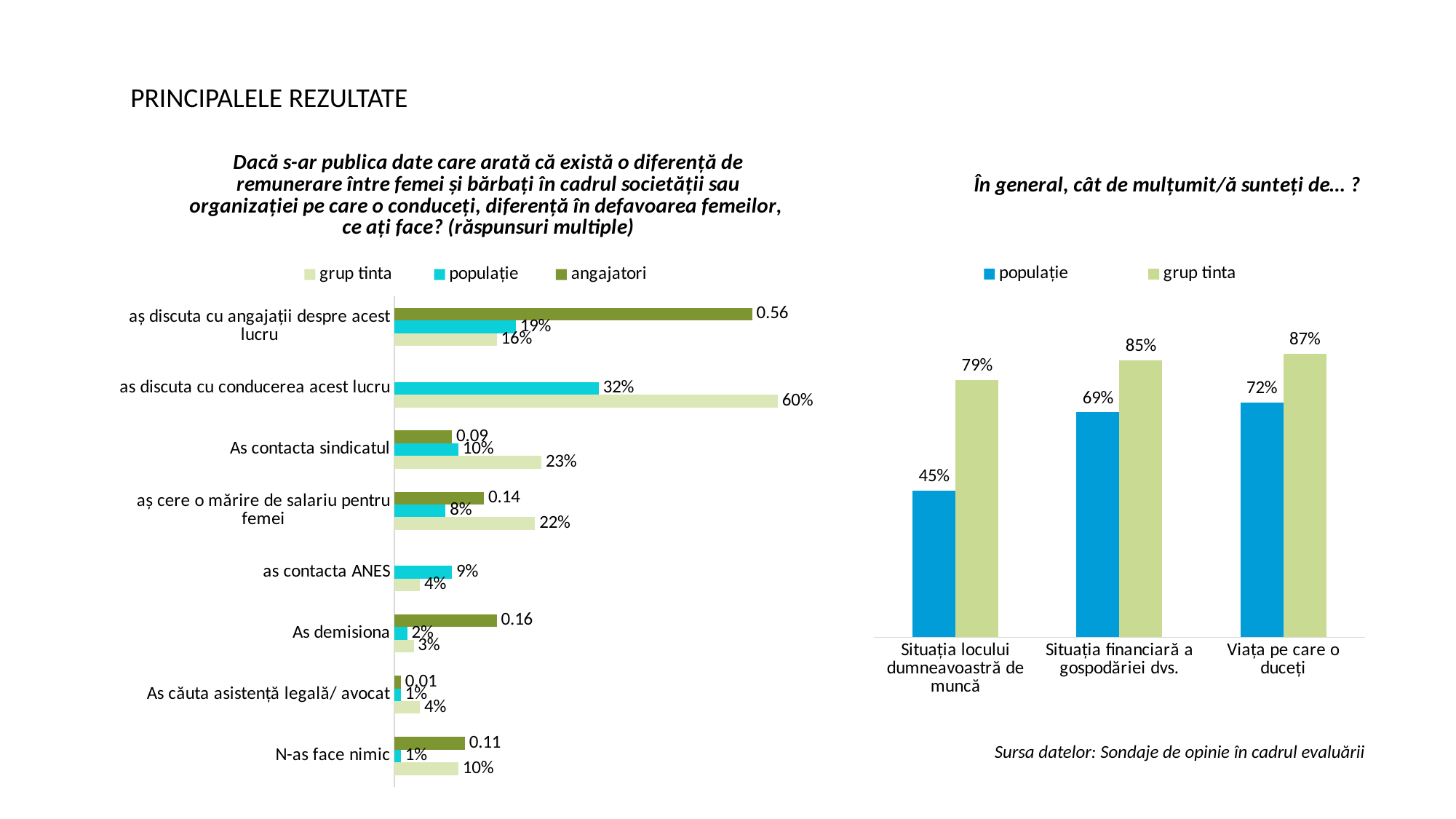
On the left chart ("Dacă s-ar publica date..."), how many categories are shown? 8 What kind of chart is the left chart ("Dacă s-ar publica date...")? bar chart On the left chart ("Dacă s-ar publica date..."), what is the populație value for "As contacta sindicatul"? 10% On the right chart ("În general, cât de mulțumit/ă sunteți de... ?"), what is the value for populație for "Situația locului dumneavoastră de muncă"? 45% On the right chart ("În general, cât de mulțumit/ă sunteți de... ?"), what is the value for grup tinta for "Viața pe care o duceți"? 87% On the left chart ("Dacă s-ar publica date..."), which is larger for "as contacta ANES": the populație value or the grup tinta value? populație On the right chart ("În general, cât de mulțumit/ă sunteți de... ?"), which category has the lowest populație value? Situația locului dumneavoastră de muncă On the right chart ("În general, cât de mulțumit/ă sunteți de... ?"), do the populație values rise or fall from left to right across the categories? rise On the right chart ("În general, cât de mulțumit/ă sunteți de... ?"), how many series does the legend list? 2 On the left chart ("Dacă s-ar publica date..."), what is the angajatori value for "aș discuta cu angajații despre acest lucru"? 0.56 On the left chart ("Dacă s-ar publica date..."), what is the grup tinta value for "as discuta cu conducerea acest lucru"? 60% On the right chart ("În general, cât de mulțumit/ă sunteți de... ?"), what is the difference between grup tinta and populație for "Situația financiară a gospodăriei dvs."? 16%